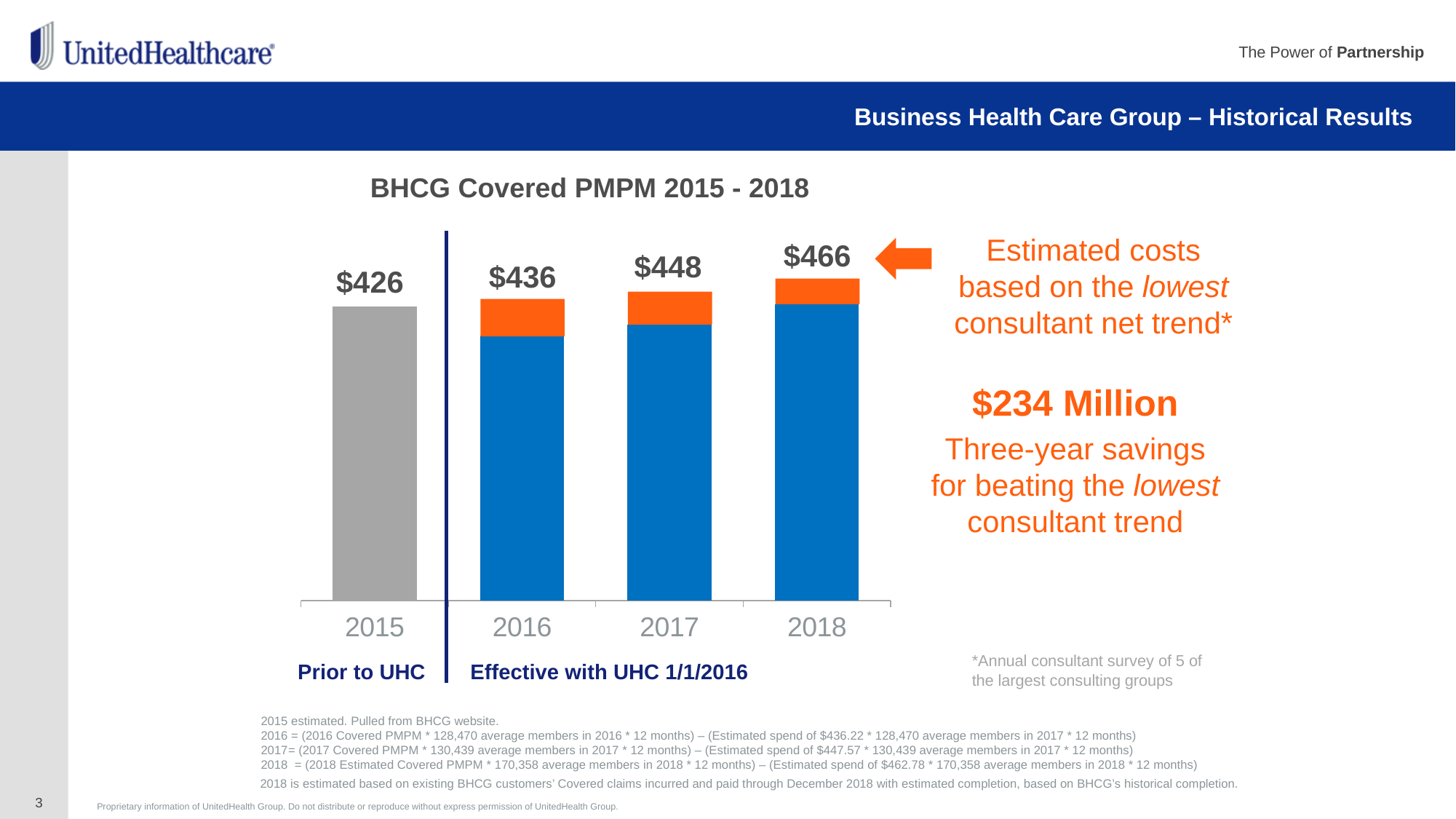
How many years are shown on the x axis of the chart? 4 Which year has the lowest labeled value in the chart? 2015 Which year has the highest labeled value in the chart? 2018 What value is labeled above the 2017 bar? $448 What value is labeled above the 2018 bar? $466 What value is labeled above the 2016 bar? $436 What is the difference between the labeled values for 2018 and 2015? $40 What kind of chart is shown on the slide? Bar chart What is the difference between the labeled values for 2017 and 2016? $12 What value is labeled above the 2015 bar in the BHCG Covered PMPM chart? $426 Do the labeled values rise or fall from 2015 to 2018? Rise Which year has the larger labeled value, 2016 or 2017? 2017